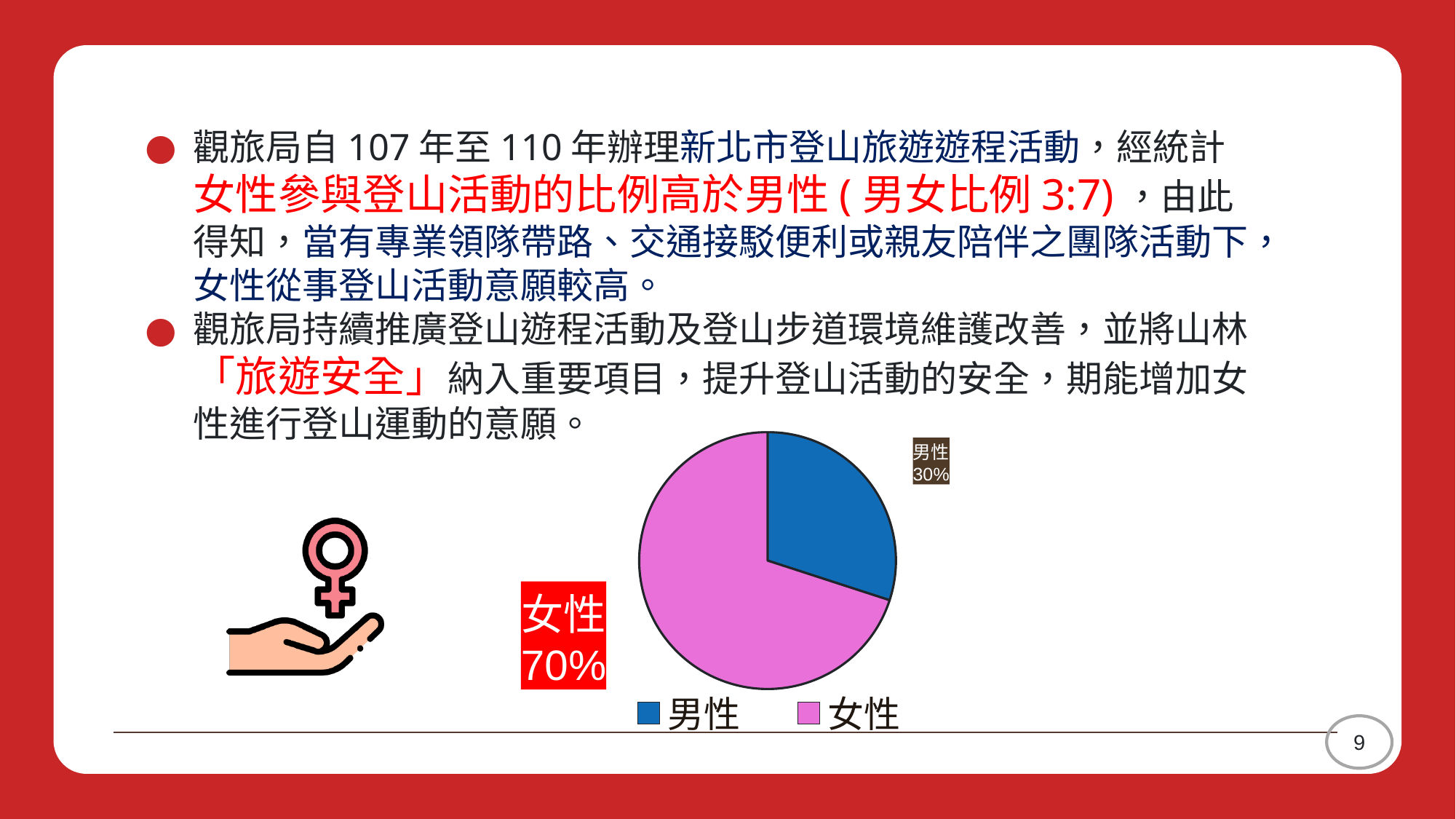
Which slice of the pie chart is the largest? 女性 What share of the pie chart is 男性? 30% How many slices does the pie chart have? 2 What colour is the 男性 slice in the pie chart? blue What colour is the 女性 slice in the pie chart? pink What share of the pie chart is 女性? 70% How many entries does the legend of the pie chart list? 2 Which slice of the pie chart is the smallest? 男性 What kind of chart is shown on the slide? pie chart What is the difference between the 女性 and 男性 shares in the pie chart? 40% Which is larger in the pie chart, 男性 or 女性? 女性